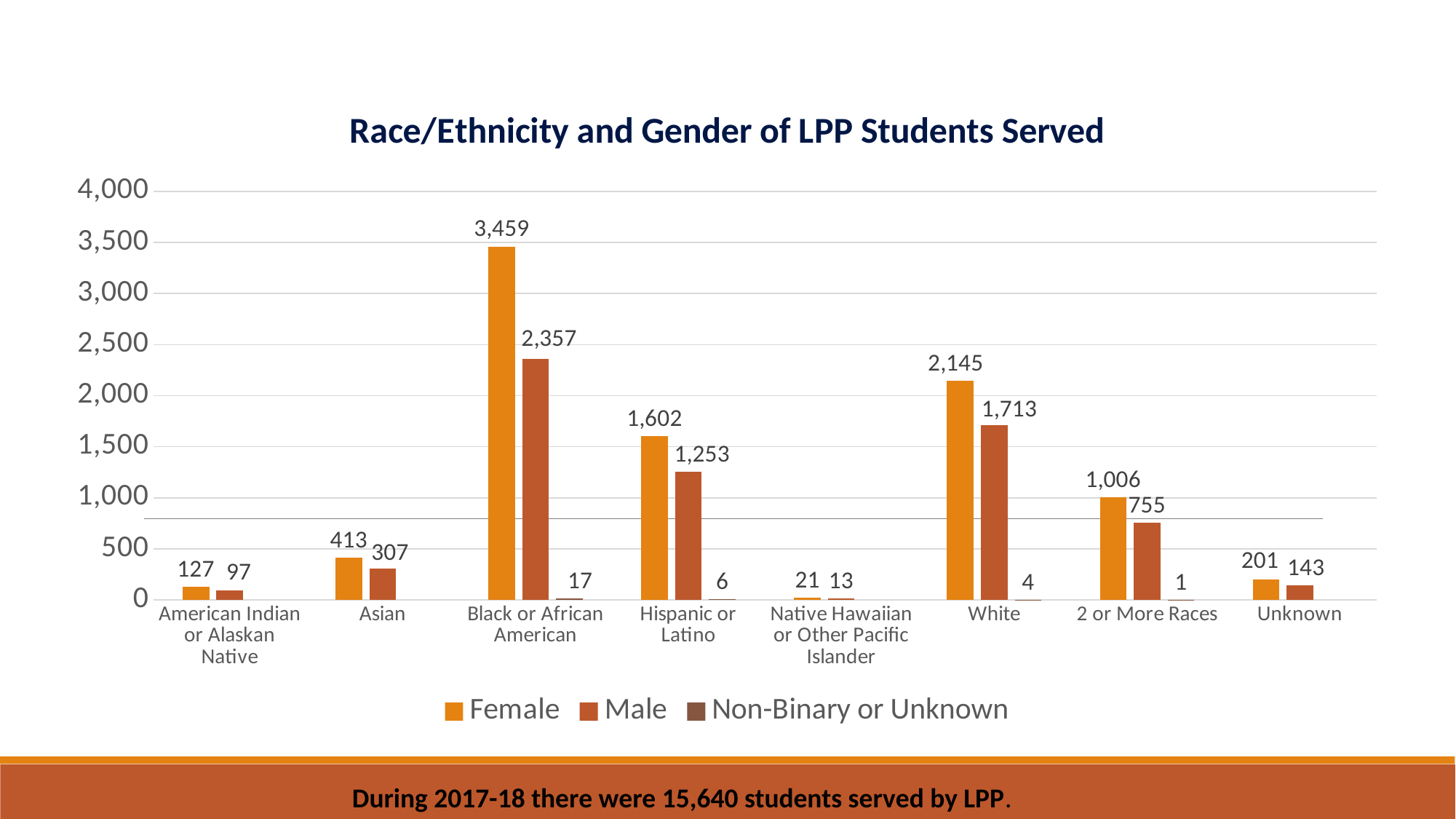
Which category has the highest Female value? Black or African American What is the title of the chart? Race/Ethnicity and Gender of LPP Students Served What is the Non-Binary or Unknown value for Hispanic or Latino? 6 Is the Male value for Hispanic or Latino greater or less than 1,000? greater Which category has the lowest Male value? Native Hawaiian or Other Pacific Islander How many race/ethnicity categories are shown on the x axis? 8 What is the Female value for Black or African American? 3,459 How many series does the legend list? 3 What is the difference between the Female and Male values for Black or African American? 1,102 What kind of chart is shown on the slide? Bar chart What is the Male value for White? 1,713 Which is larger, the Female value for Asian or the Female value for Unknown? Female value for Asian